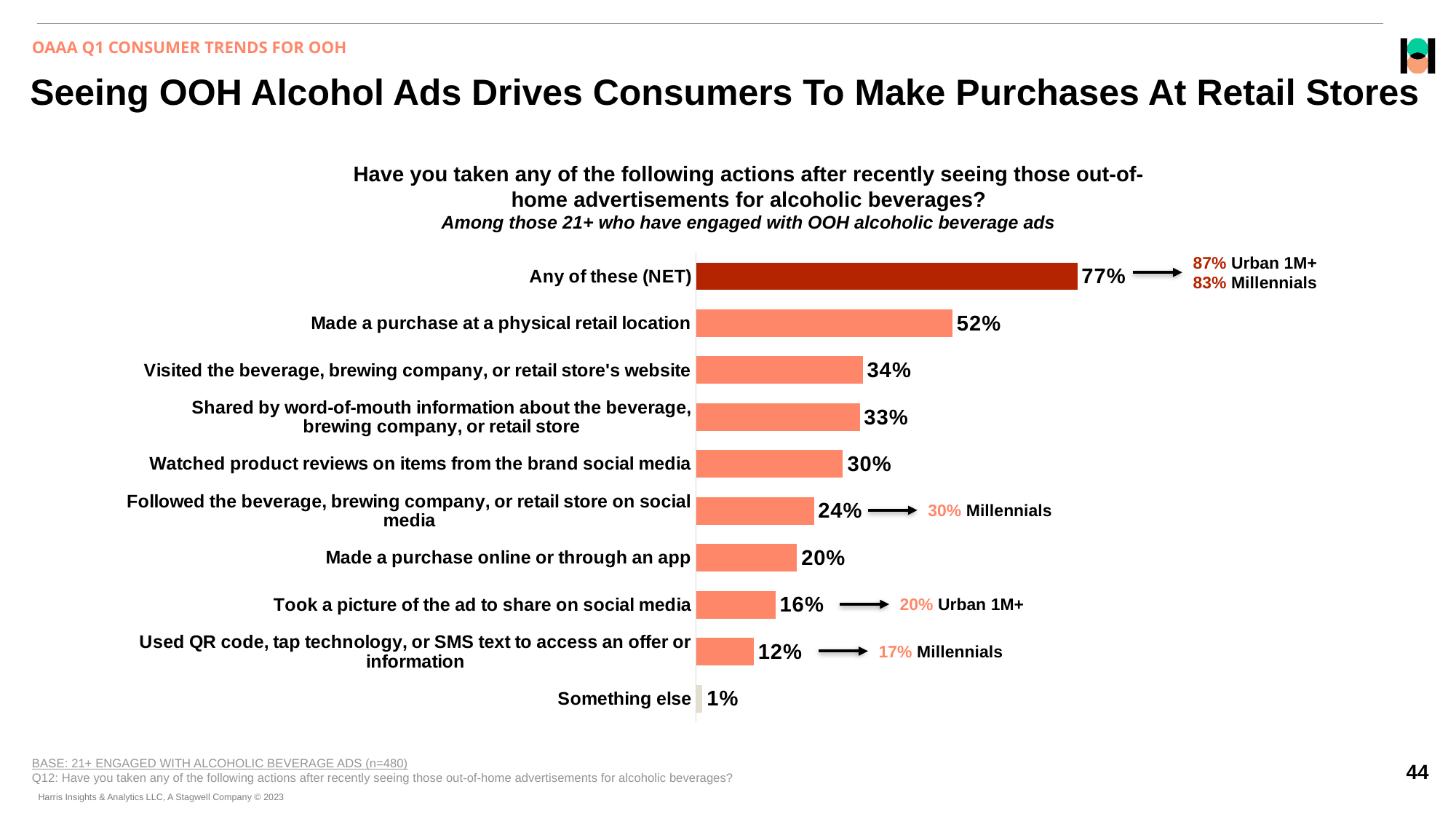
What is the difference between 'Took a picture of the ad to share on social media' and 'Used QR code, tap technology, or SMS text to access an offer or information'? 4% Which is larger: 'Visited the beverage, brewing company, or retail store's website' or 'Watched product reviews on items from the brand social media'? Visited the beverage, brewing company, or retail store's website Which action, excluding the NET bar, has the highest percentage? Made a purchase at a physical retail location What percentage of respondents made a purchase at a physical retail location after seeing OOH alcohol ads? 52% Which category has the lowest value on the chart? Something else What type of chart is shown on the slide? Bar chart How many categories (bars) are shown on the chart? 10 What is the Urban 1M+ value shown in the callout for 'Any of these (NET)'? 87% What is the value for 'Any of these (NET)'? 77% What percentage of Millennials followed the beverage, brewing company, or retail store on social media, according to the callout? 30% What is the difference between 'Made a purchase at a physical retail location' and 'Made a purchase online or through an app'? 32% What percentage used a QR code, tap technology, or SMS text to access an offer or information? 12%